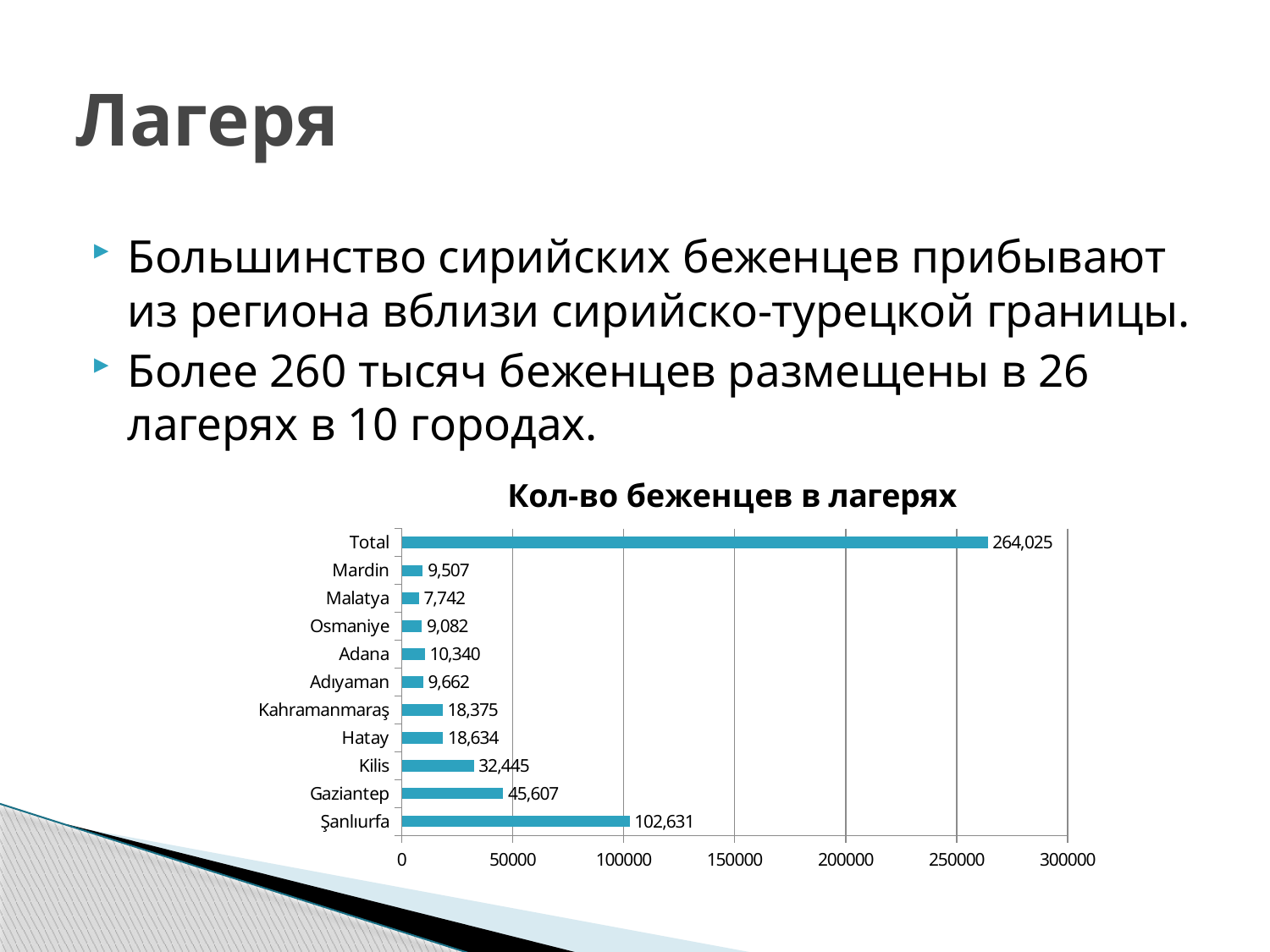
What is the title of the chart? Кол-во беженцев в лагерях What is the value for Şanlıurfa? 102,631 How many bars are plotted in the chart, including Total? 11 What is the value for Gaziantep? 45,607 What is the value shown for Total? 264,025 What is the value for Adıyaman? 9,662 Which city has the lowest value? Malatya Is the value for Kilis greater or less than 50000? less Which is larger, the value for Kilis or the value for Gaziantep? Gaziantep Excluding the Total bar, which city has the highest value? Şanlıurfa What is the difference between the values for Gaziantep and Kilis? 13,162 What kind of chart is shown on the slide? bar chart